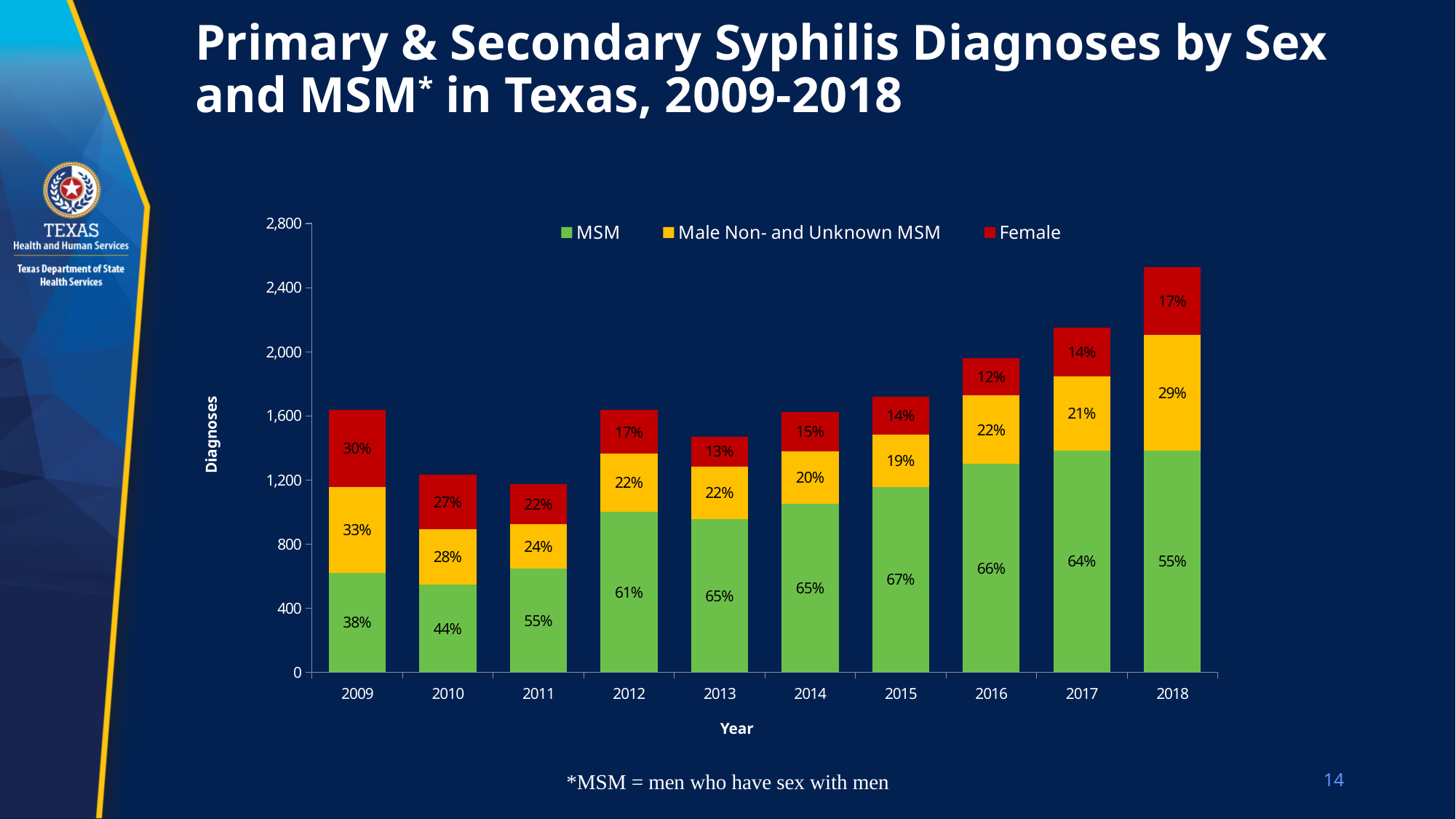
By how many percentage points does the MSM label in 2018 exceed the MSM label in 2009? 17 percentage points What kind of chart is shown on the slide? Stacked bar chart Is the total height of the 2018 bar greater or less than 2,400 diagnoses? greater How many years are shown on the x axis? 10 Which year has the larger Female percentage label, 2009 or 2010? 2009 In which year is the Female percentage label the lowest? 2016 What percentage label is shown for the Male Non- and Unknown MSM segment in 2012? 22% What percentage label is shown for the MSM segment in 2009? 38% In which year is the MSM percentage label the highest? 2015 Is the total height of the 2010 bar greater or less than 1,600 diagnoses? less How many series does the legend list? 3 What percentage label is shown for the Female segment in 2018? 17%